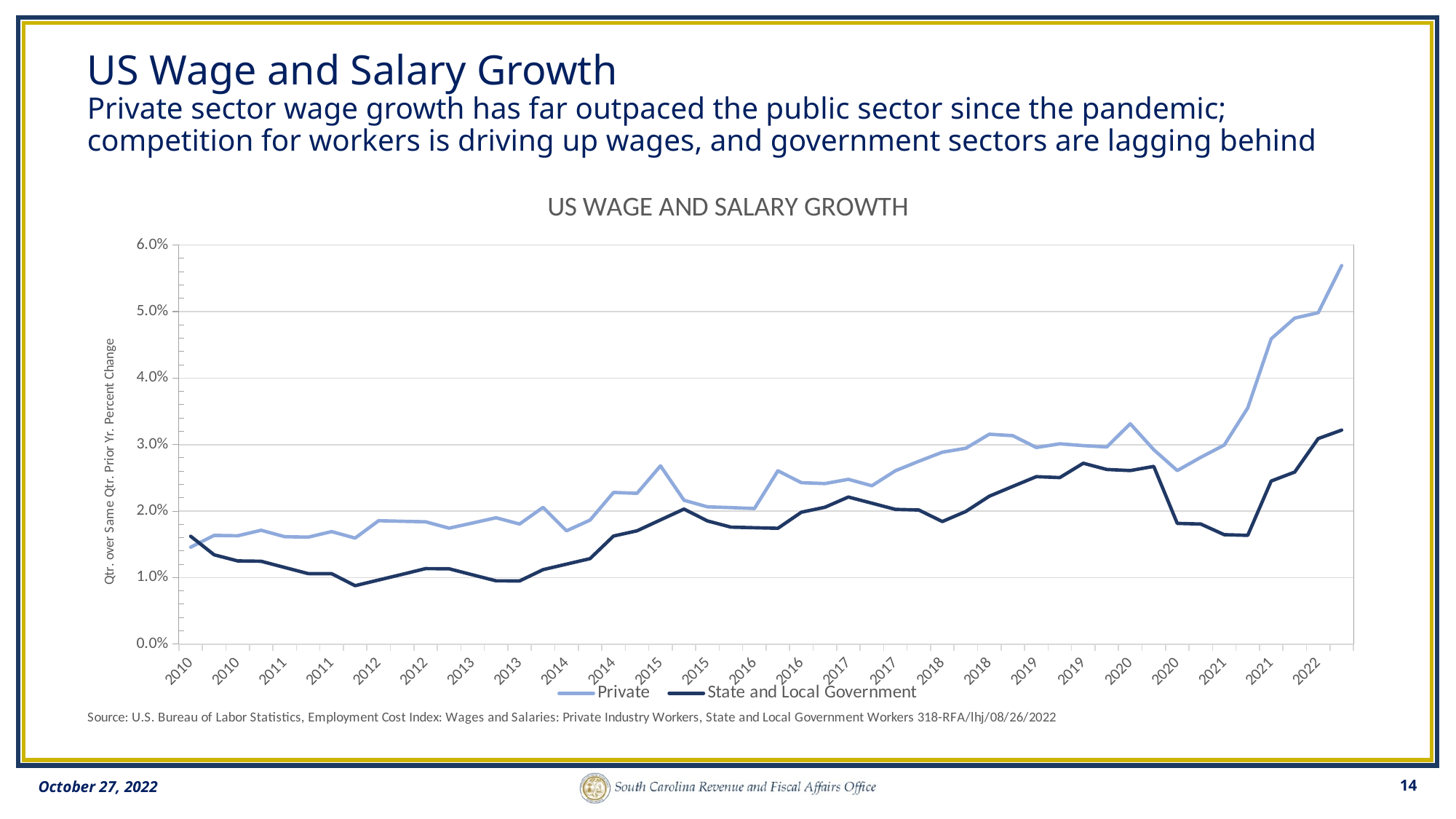
At the last point in 2022, which series has the higher value, Private or State and Local Government? Private What is the label on the vertical axis of the chart? Qtr. over Same Qtr. Prior Yr. Percent Change What is the title of the chart? US WAGE AND SALARY GROWTH At the last point in 2022, is the value for Private greater or less than 5.0%? greater Which series has the lowest point anywhere on the chart? State and Local Government Which series reaches the highest value anywhere on the chart? Private Does the Private series rise or fall between 2020 and the end of 2022? Rise At its lowest point around 2011-2012, is the value for State and Local Government greater or less than 1.0%? less What kind of chart is shown on the slide? Line chart At the last point in 2022, is the value for State and Local Government greater or less than 2.0%? greater Does the State and Local Government series rise or fall between 2010 and 2012? Fall How many series does the chart's legend list? 2